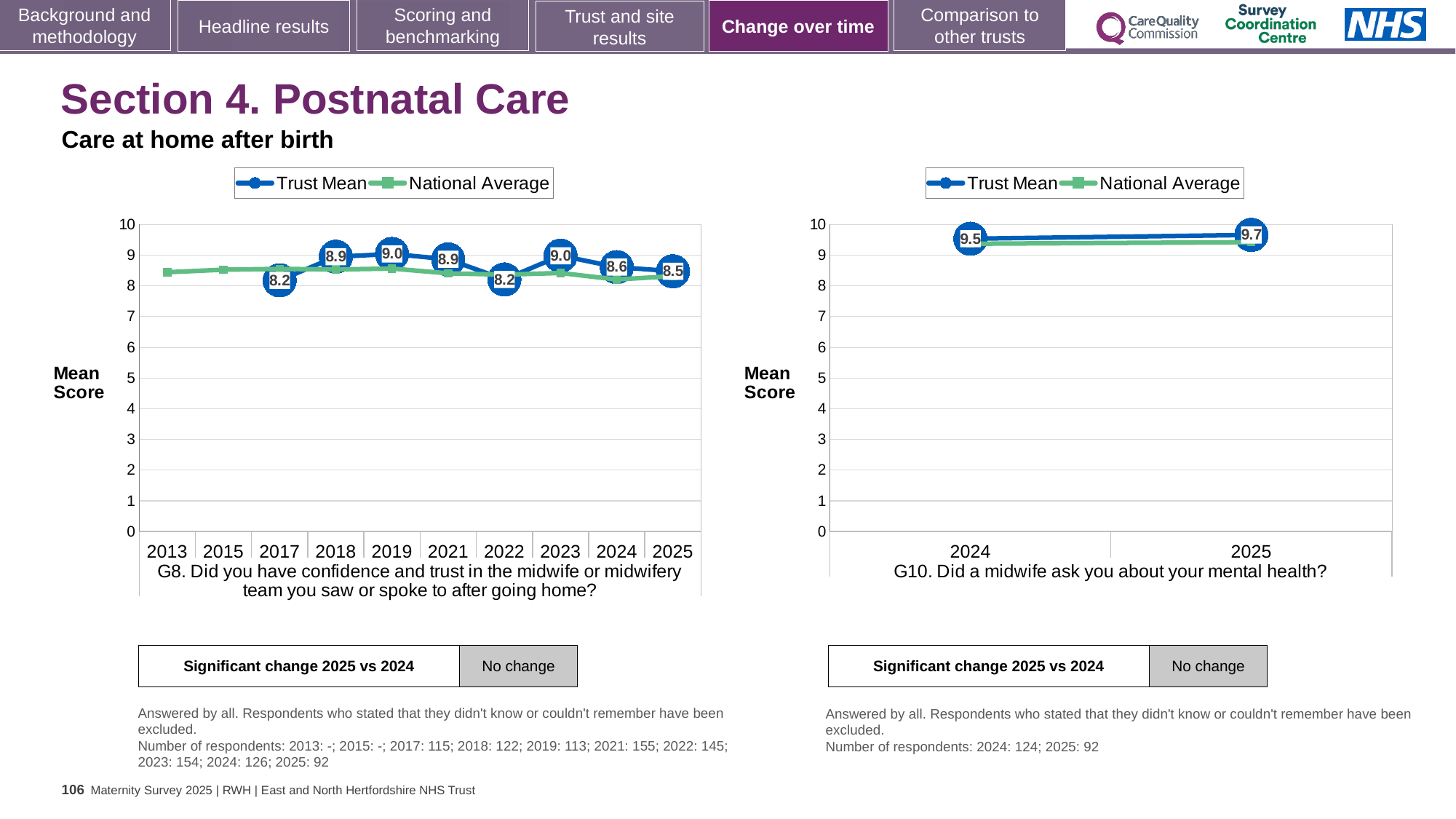
In the G8 chart on the left, what is the Trust Mean score for 2019? 9.0 In the G10 chart on the right, by how much did the Trust Mean score change from 2024 to 2025? 0.2 In the G10 chart on the right, what is the Trust Mean score for 2024? 9.5 In the G10 chart on the right, what is the Trust Mean score for 2025? 9.7 In the G8 chart on the left, what is the Trust Mean score for 2025? 8.5 In the G8 chart on the left, what is the Trust Mean score for 2022? 8.2 How many years are shown on the x axis of the G8 chart on the left? 10 In the G8 chart on the left, is the National Average value for 2013 greater or less than 8? greater How many series does the legend of the G10 chart on the right list? 2 In the G8 chart on the left, what is the difference between the Trust Mean scores for 2024 and 2025? 0.1 In the G8 chart on the left, which year has the higher Trust Mean score, 2017 or 2018? 2018 In the G10 chart on the right, does the Trust Mean rise or fall from 2024 to 2025? rise